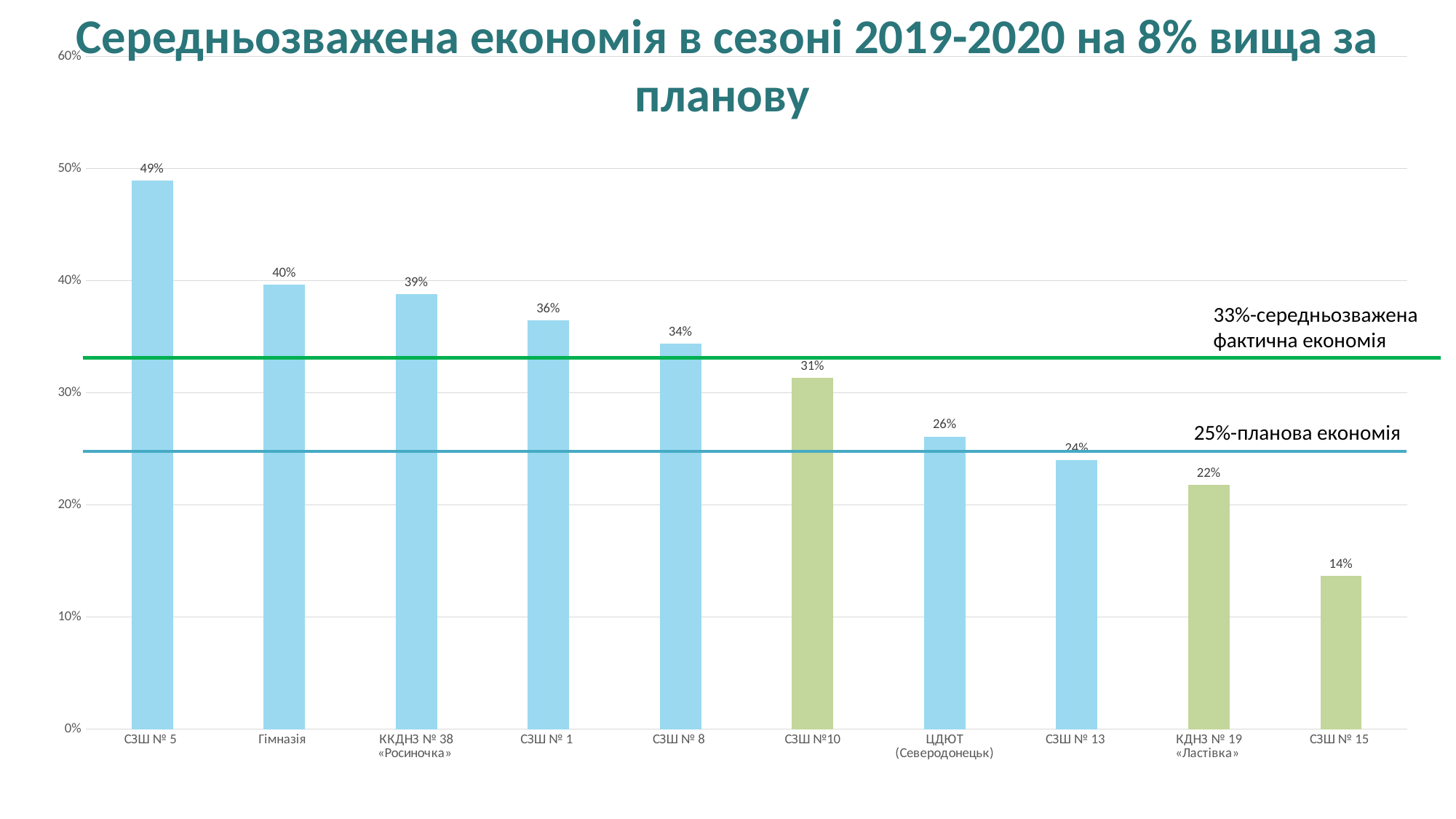
Is the value for СЗШ № 1 greater or less than 30%? greater What is the value for СЗШ № 5? 49% Which category has the highest value? СЗШ № 5 What is the value for ЦДЮТ (Северодонецьк)? 26% Which category has the lowest value? СЗШ № 15 What is the difference between the values for Гімназія and СЗШ № 15? 26% What value does the green horizontal line labelled 'середньозважена фактична економія' mark? 33% How many categories are shown on the x axis? 10 Which is larger, the value for СЗШ № 8 or the value for СЗШ №10? СЗШ № 8 What kind of chart is shown on the slide? bar chart What is the value for КДНЗ № 19 «Ластівка»? 22% Do the bar values rise or fall from left to right along the x axis? fall